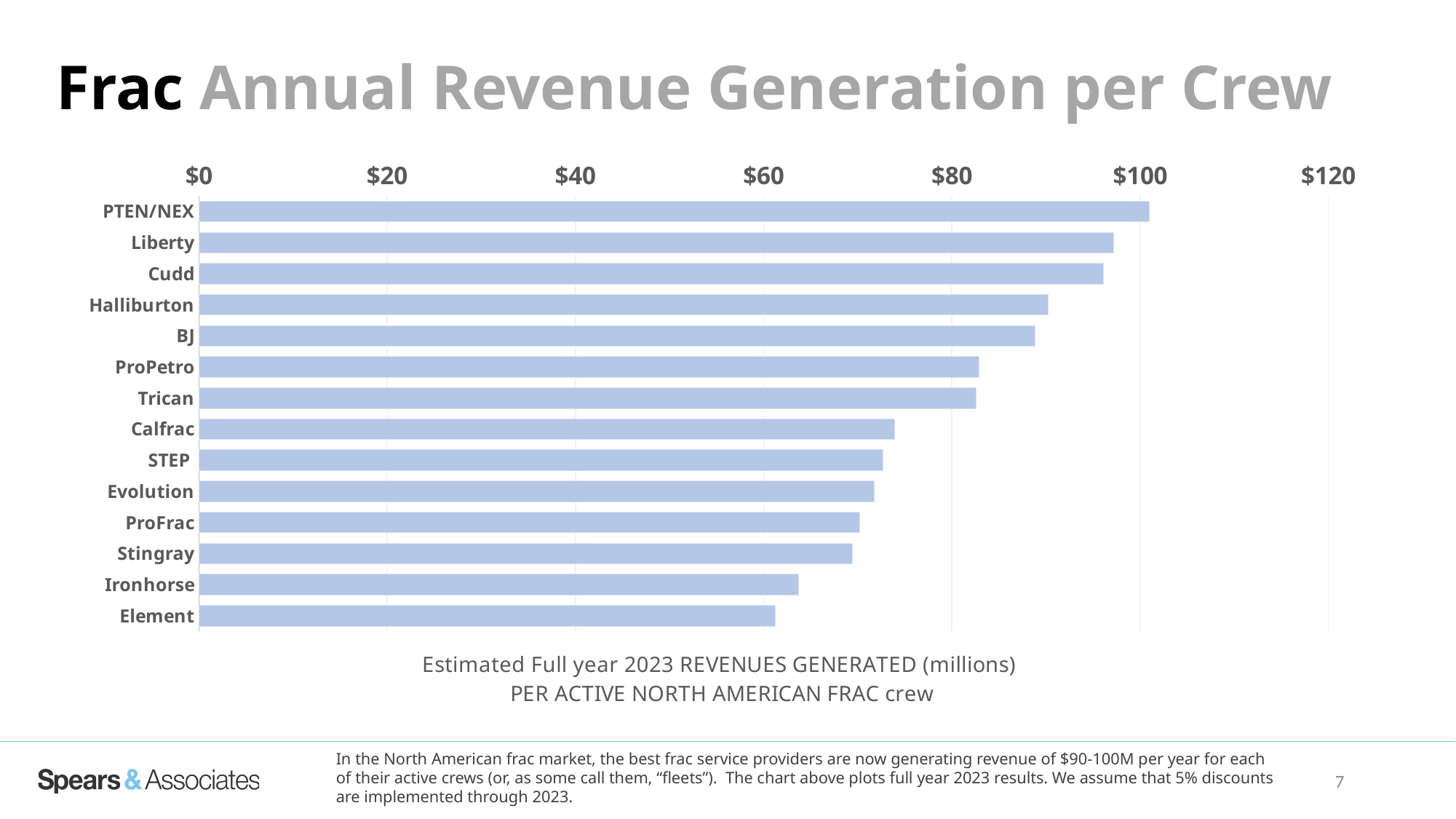
Is the value for Halliburton greater or less than $80? greater Is the value for Ironhorse greater or less than $80? less Is the value for Liberty greater or less than $80? greater Which has a higher revenue per crew, Halliburton or Calfrac? Halliburton What kind of chart is shown on the slide? bar chart Which company has the highest annual revenue generation per crew? PTEN/NEX Do the bar values rise or fall going from the top of the chart to the bottom? fall Which has a lower revenue per crew, Liberty or Ironhorse? Ironhorse Which company has the lowest annual revenue generation per crew? Element How many companies are plotted in the chart? 14 What is the title of the slide? Frac Annual Revenue Generation per Crew